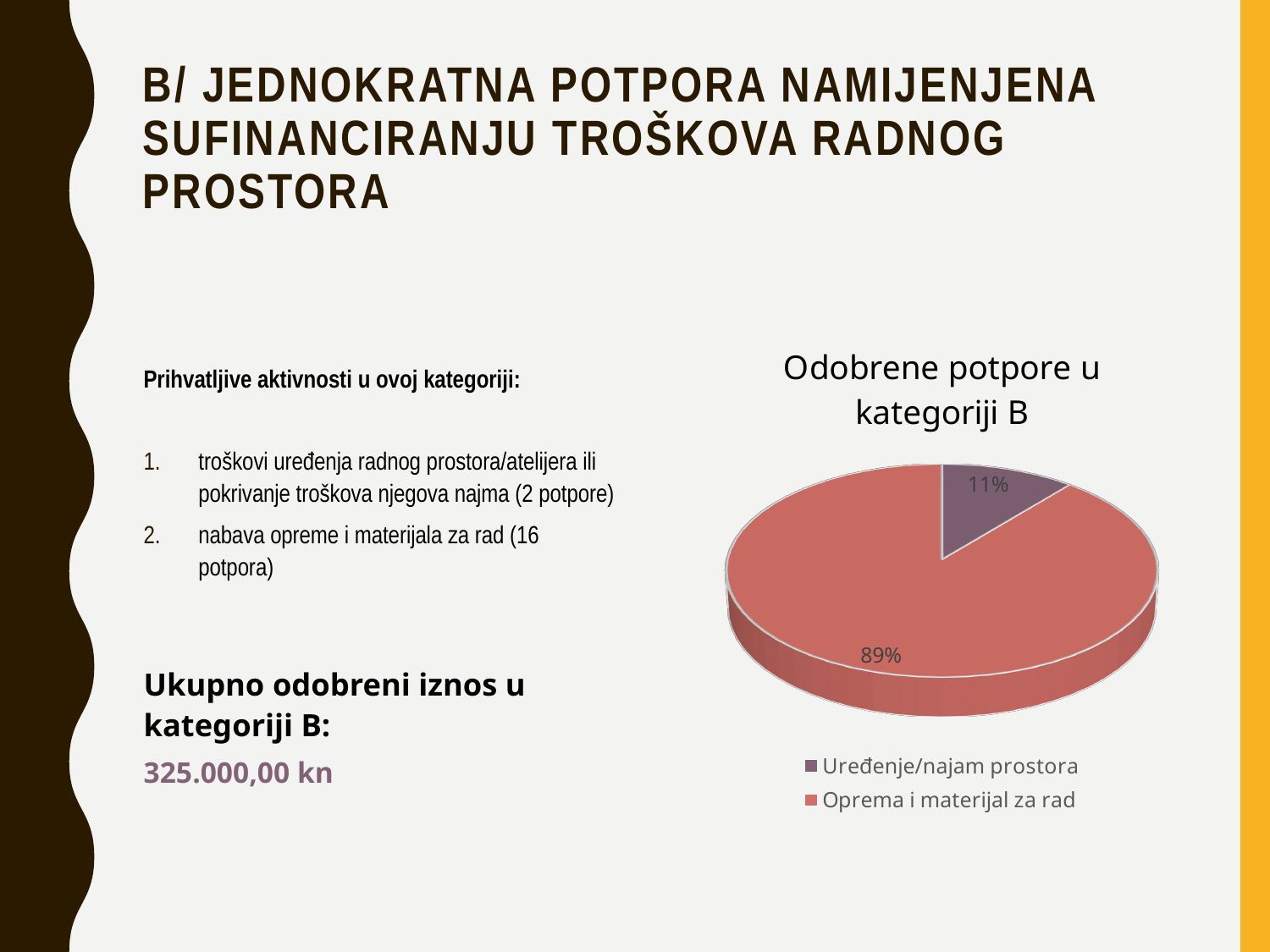
What kind of chart is shown on the slide? pie chart What is the difference in percentage points between the "Oprema i materijal za rad" slice and the "Uređenje/najam prostora" slice? 78 percentage points Which legend entry is shown in red? Oprema i materijal za rad What share of the pie does "Oprema i materijal za rad" take? 89% How many entries does the legend list? 2 What is the title of the chart? Odobrene potpore u kategoriji B Which is larger: the share for "Uređenje/najam prostora" or the share for "Oprema i materijal za rad"? Oprema i materijal za rad Which category has the largest slice of the pie? Oprema i materijal za rad What share of the pie does "Uređenje/najam prostora" take? 11% Which category has the smallest slice of the pie? Uređenje/najam prostora How many categories does the pie chart show? 2